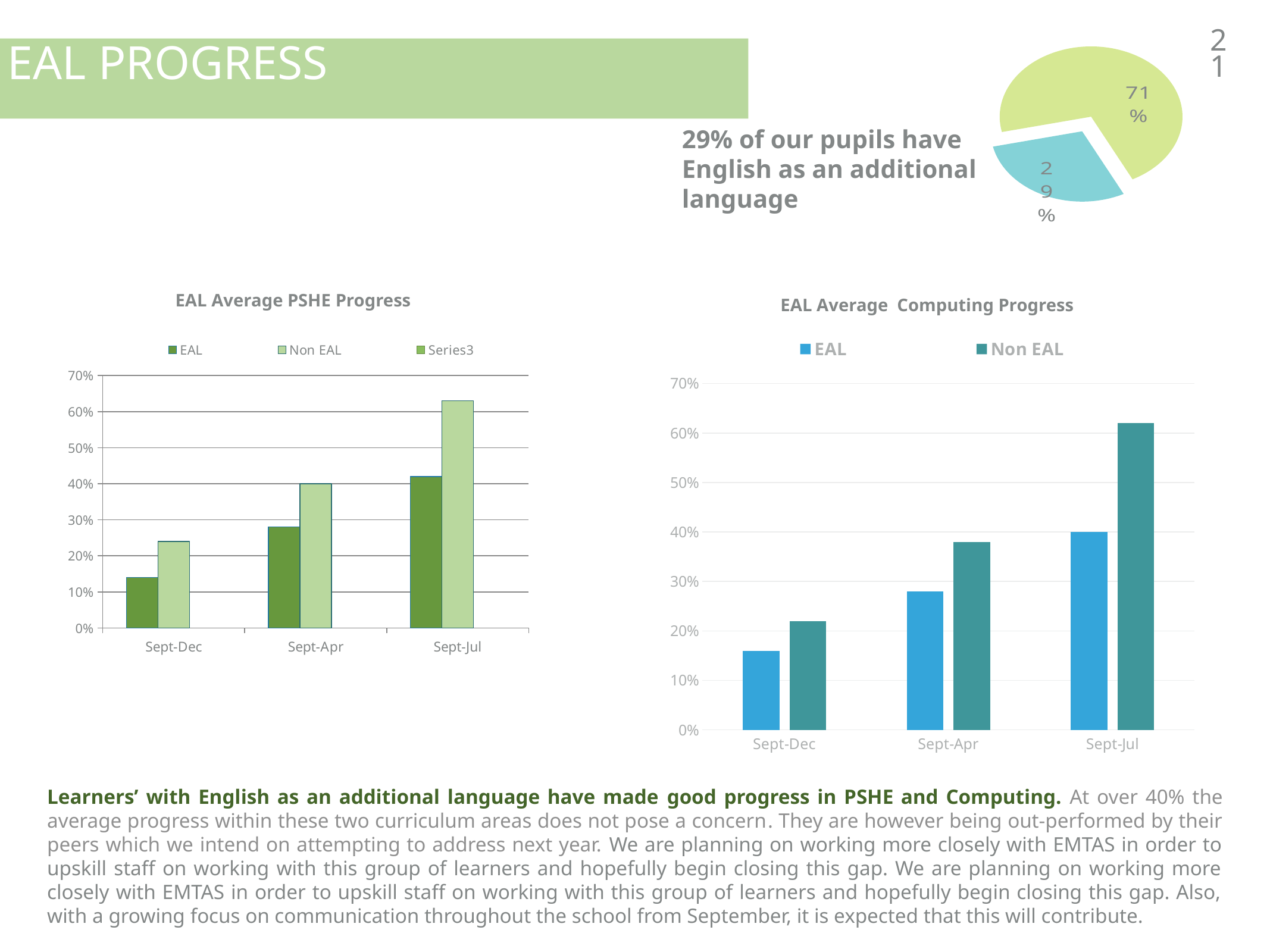
How many slices does the pie chart at the top right have? 2 How many series does the legend of the 'EAL Average Computing Progress' chart list? 2 In the pie chart at the top right, what percentage is shown for the smaller slice? 29% In the 'EAL Average Computing Progress' chart, is the Non EAL value for Sept-Jul greater or less than 60%? greater In the pie chart at the top right, what percentage is shown for the larger slice? 71% In the 'EAL Average PSHE Progress' chart, is the Non EAL value for Sept-Jul greater or less than 60%? greater How many series does the legend of the 'EAL Average PSHE Progress' chart list? 3 How many categories are shown on the x axis of the 'EAL Average Computing Progress' chart? 3 What type of chart is 'EAL Average PSHE Progress'? bar chart In the 'EAL Average Computing Progress' chart, do the EAL values rise or fall from Sept-Dec to Sept-Jul? rise In the 'EAL Average Computing Progress' chart, which bar is the highest? Non EAL, Sept-Jul In the 'EAL Average PSHE Progress' chart, is the EAL value for Sept-Dec greater or less than 20%? less